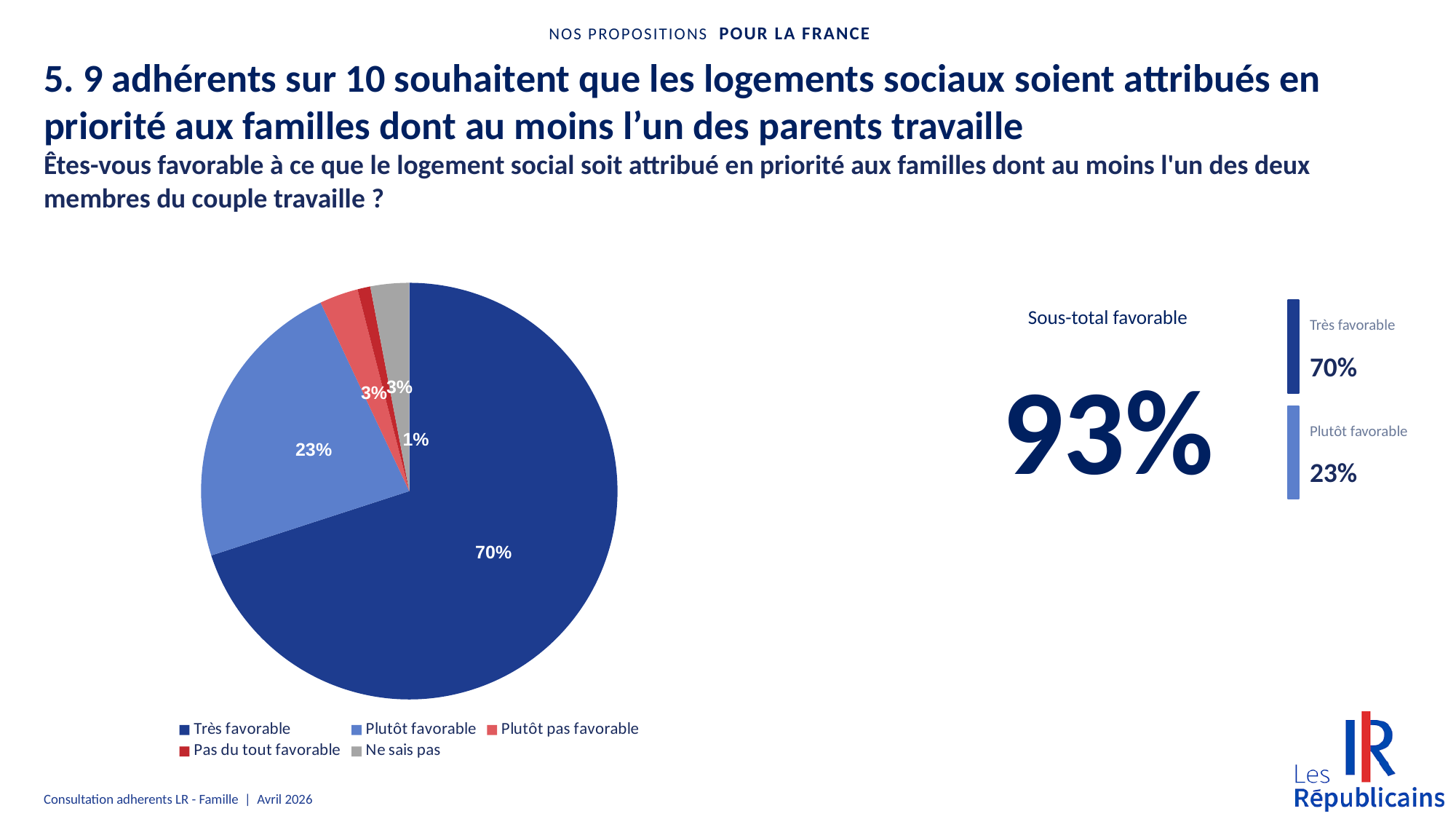
How many response categories does the pie chart show? 5 What percentage of respondents answered "Pas du tout favorable"? 1% Which is larger, the share for "Plutôt favorable" or the share for "Ne sais pas"? Plutôt favorable Which response category has the largest slice of the pie? Très favorable What percentage of respondents answered "Très favorable"? 70% Which response category has the smallest slice of the pie? Pas du tout favorable What colour is the "Ne sais pas" slice in the pie chart? grey What is the combined share of "Très favorable" and "Plutôt favorable" (the "Sous-total favorable")? 93% What percentage of respondents answered "Ne sais pas"? 3% What percentage of respondents answered "Plutôt favorable"? 23% What kind of chart is shown on the slide? pie chart What is the difference in percentage points between "Très favorable" and "Plutôt favorable"? 47